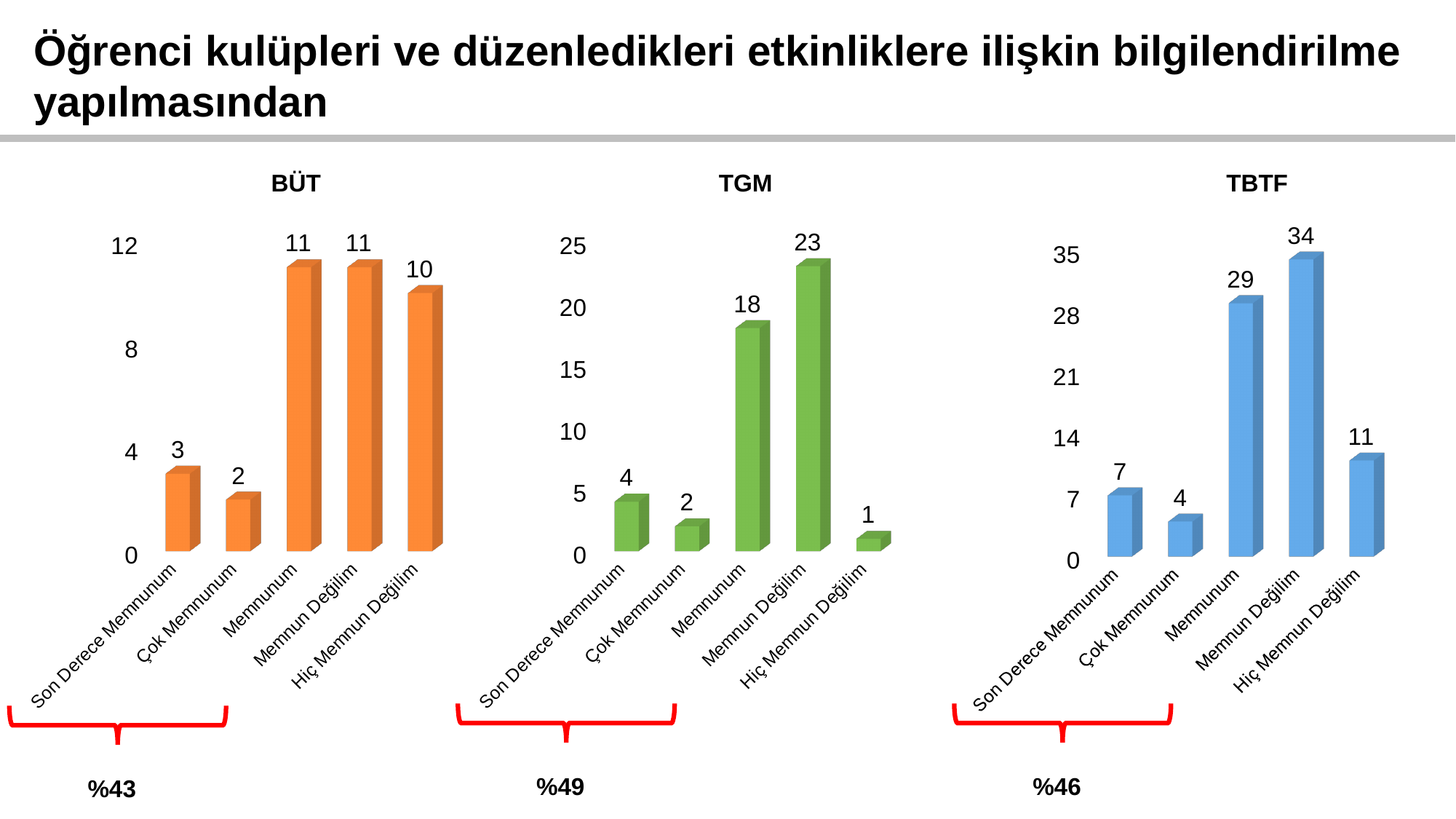
In the BÜT chart, which is larger: Son Derece Memnunum or Çok Memnunum? Son Derece Memnunum In the TBTF chart, what is the value for Son Derece Memnunum? 7 In the TGM chart, which category has the lowest value? Hiç Memnun Değilim What colour are the bars in the TGM chart? green In the BÜT chart, which category has the lowest value? Çok Memnunum How many categories does the TGM chart show? 5 In the TGM chart, what is the difference between Memnunum and Son Derece Memnunum? 14 What type of chart is the TBTF chart? bar chart In the TBTF chart, which category has the highest value? Memnun Değilim In the BÜT chart, what is the value for Hiç Memnun Değilim? 10 In the TGM chart, what is the value for Memnun Değilim? 23 In the TBTF chart, what is the difference between Memnun Değilim and Memnunum? 5